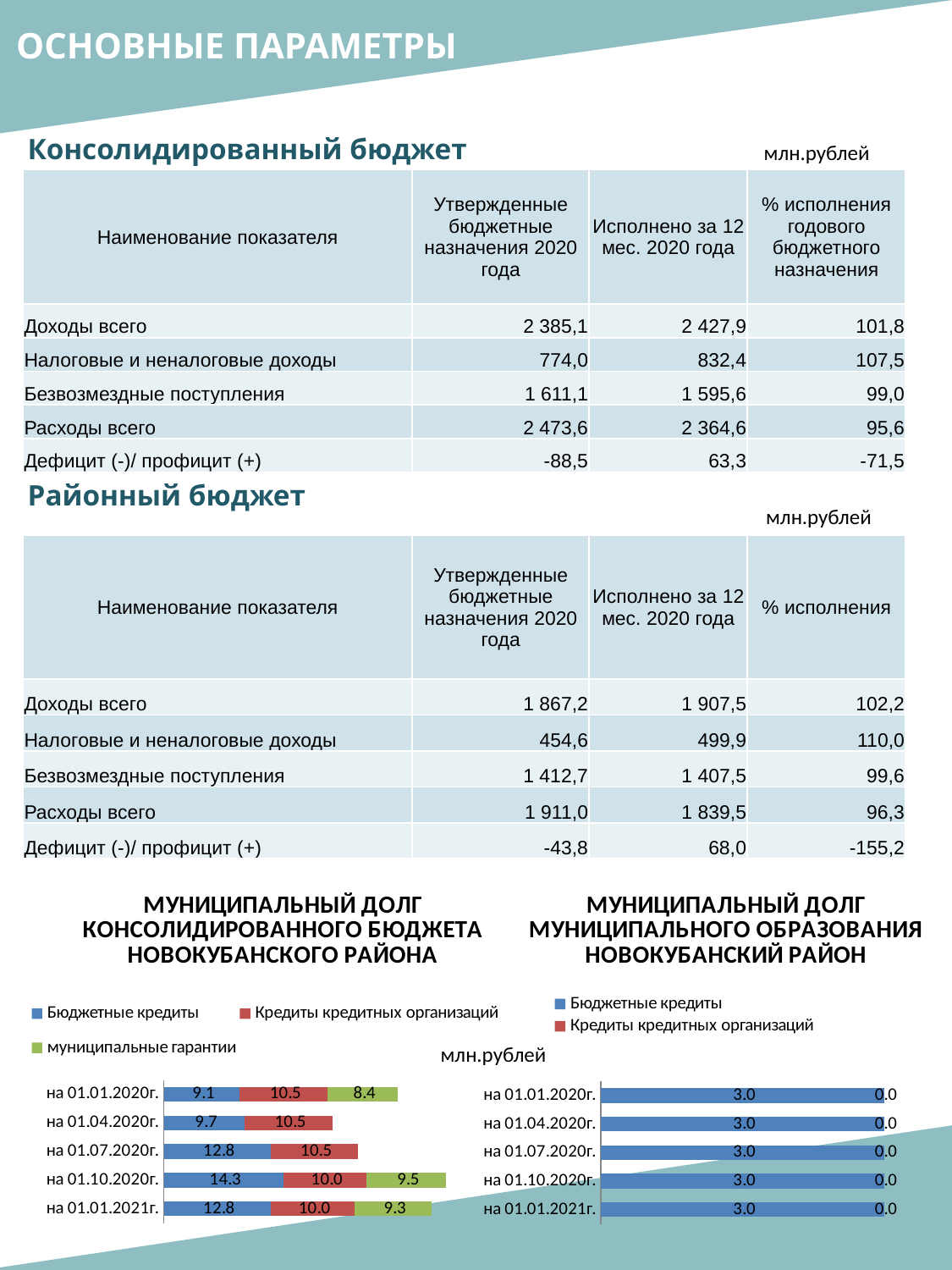
In the left chart (Муниципальный долг консолидированного бюджета Новокубанского района), what is the total of the stacked bar на 01.01.2021г.? 32.1 In the left chart (Муниципальный долг консолидированного бюджета Новокубанского района), on which date is Бюджетные кредиты lowest? на 01.01.2020г. In the left chart (Муниципальный долг консолидированного бюджета Новокубанского района), what is the value of Кредиты кредитных организаций на 01.01.2021г.? 10.0 In the left chart (Муниципальный долг консолидированного бюджета Новокубанского района), how many series does the legend list? 3 In the left chart (Муниципальный долг консолидированного бюджета Новокубанского района), on which date is Бюджетные кредиты highest? на 01.10.2020г. In the left chart (Муниципальный долг консолидированного бюджета Новокубанского района), what is the value of муниципальные гарантии на 01.01.2020г.? 8.4 What type of chart is the right chart (Муниципальный долг муниципального образования Новокубанский район)? Bar chart In the left chart (Муниципальный долг консолидированного бюджета Новокубанского района), how many dates are shown on the axis? 5 In the left chart (Муниципальный долг консолидированного бюджета Новокубанского района), what is the value of Бюджетные кредиты на 01.10.2020г.? 14.3 In the left chart (Муниципальный долг консолидированного бюджета Новокубанского района), what is the difference between Бюджетные кредиты на 01.10.2020г. and на 01.01.2020г.? 5.2 In the right chart (Муниципальный долг муниципального образования Новокубанский район), what is the value of Бюджетные кредиты на 01.07.2020г.? 3.0 In the right chart (Муниципальный долг муниципального образования Новокубанский район), what is the value of Кредиты кредитных организаций на 01.01.2021г.? 0.0